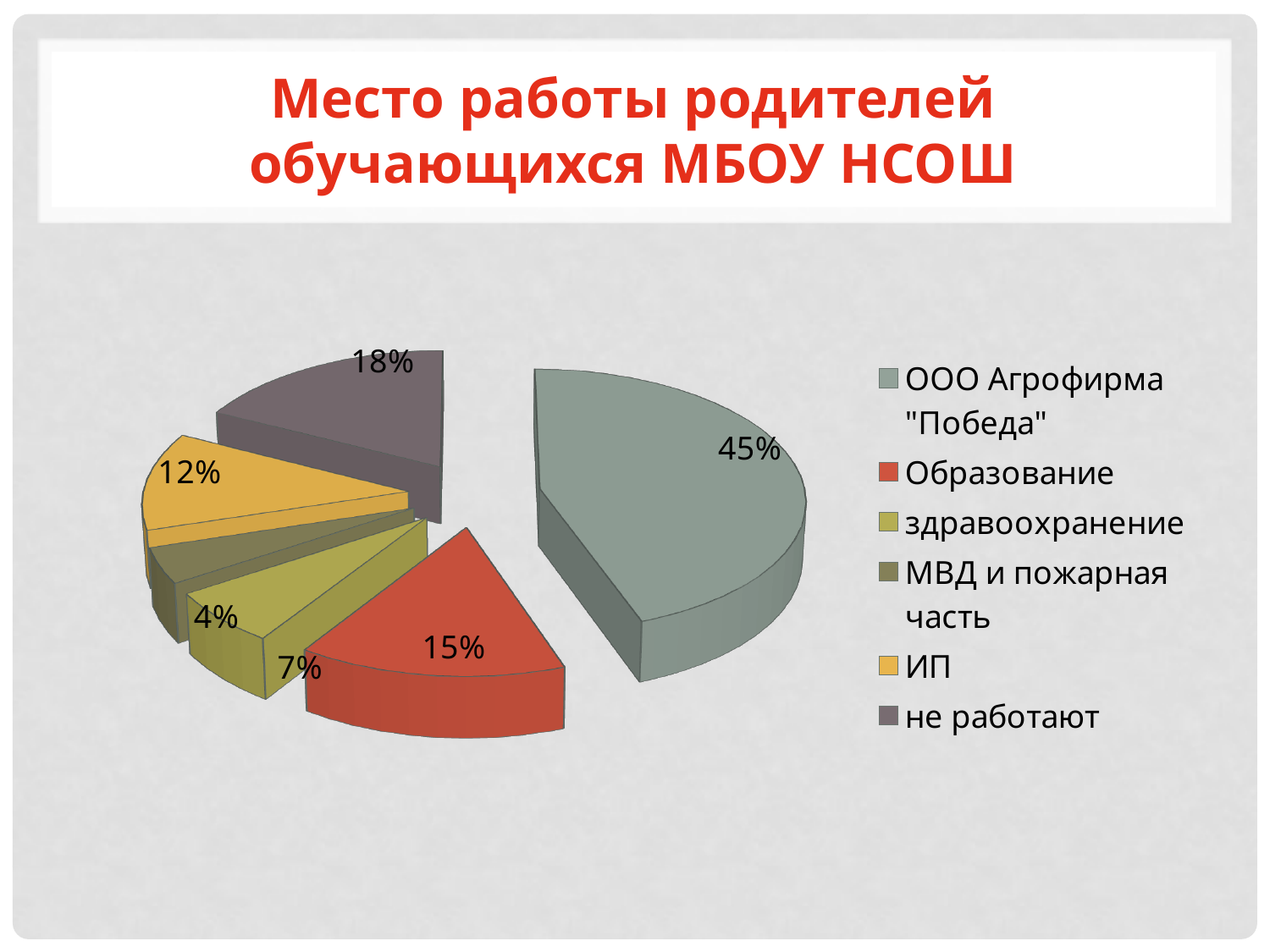
What is the value shown for ИП? 12% What kind of chart is shown on the slide? pie chart Which is larger, the share for Образование or the share for не работают? не работают Which category has the smallest slice of the pie? МВД и пожарная часть What is the value shown for Образование? 15% Which category has the largest slice of the pie? ООО Агрофирма "Победа" What is the value shown for здравоохранение? 7% What is the value shown for МВД и пожарная часть? 4% What is the difference between the shares for не работают and ИП? 6% How many categories does the legend list? 6 What share of the pie does ООО Агрофирма "Победа" have? 45% What is the value shown for не работают? 18%